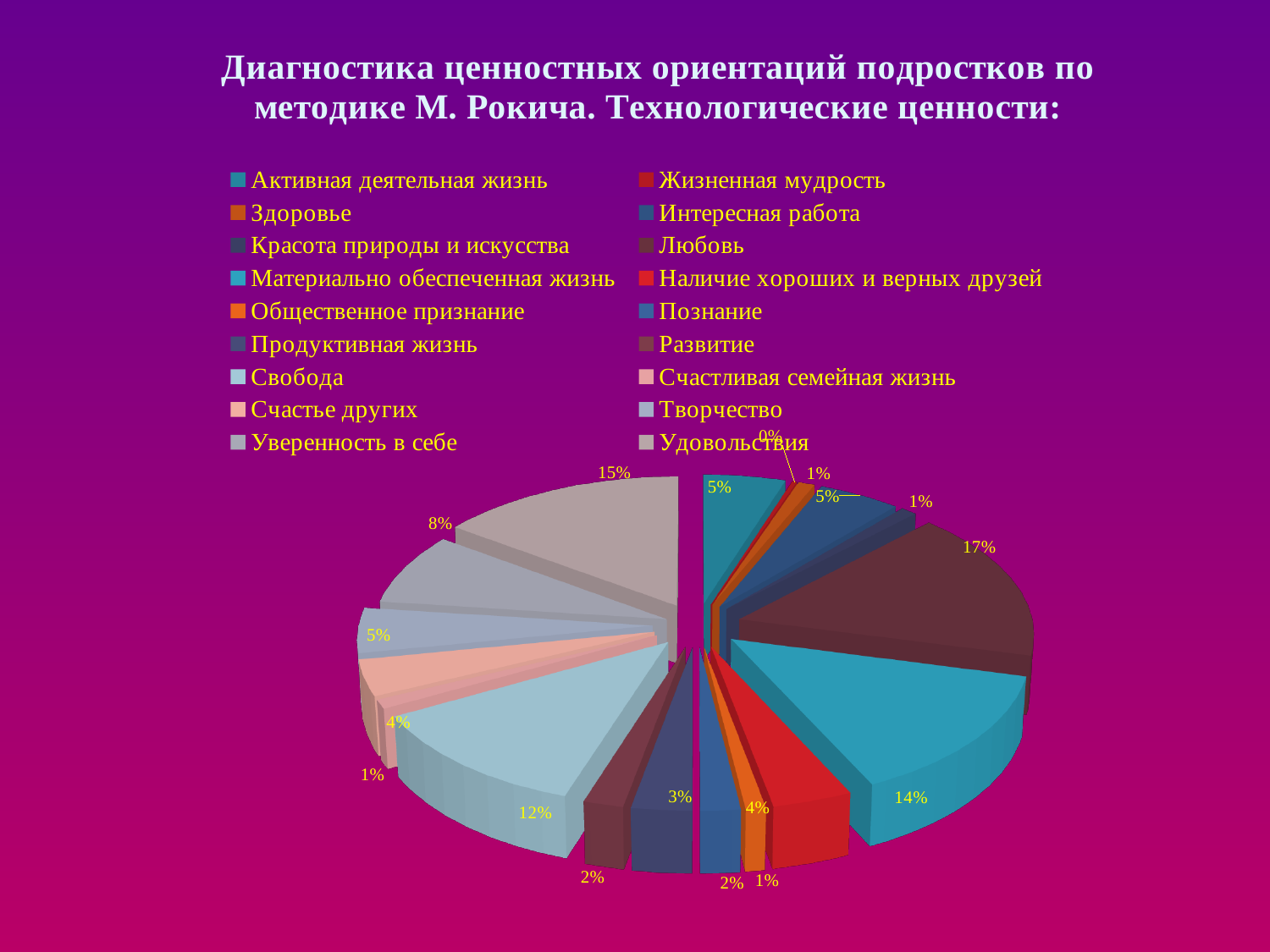
What is the smallest percentage shown on any slice of the pie chart? 0% What share of the pie does Активная деятельная жизнь have? 5% What is the difference in percentage points between the 17% slice and the 14% slice? 3 Which is larger: the slice for Любовь or the slice for Материально обеспеченная жизнь? Любовь What share of the pie does Материально обеспеченная жизнь have? 14% What share of the pie does Уверенность в себе have? 8% What is the largest percentage shown on any slice of the pie chart? 17% How many categories does the legend of the pie chart list? 18 What kind of chart is shown on the slide? pie chart Which category has the largest slice (17%) in the pie chart? Любовь What is the first legend entry of the pie chart? Активная деятельная жизнь